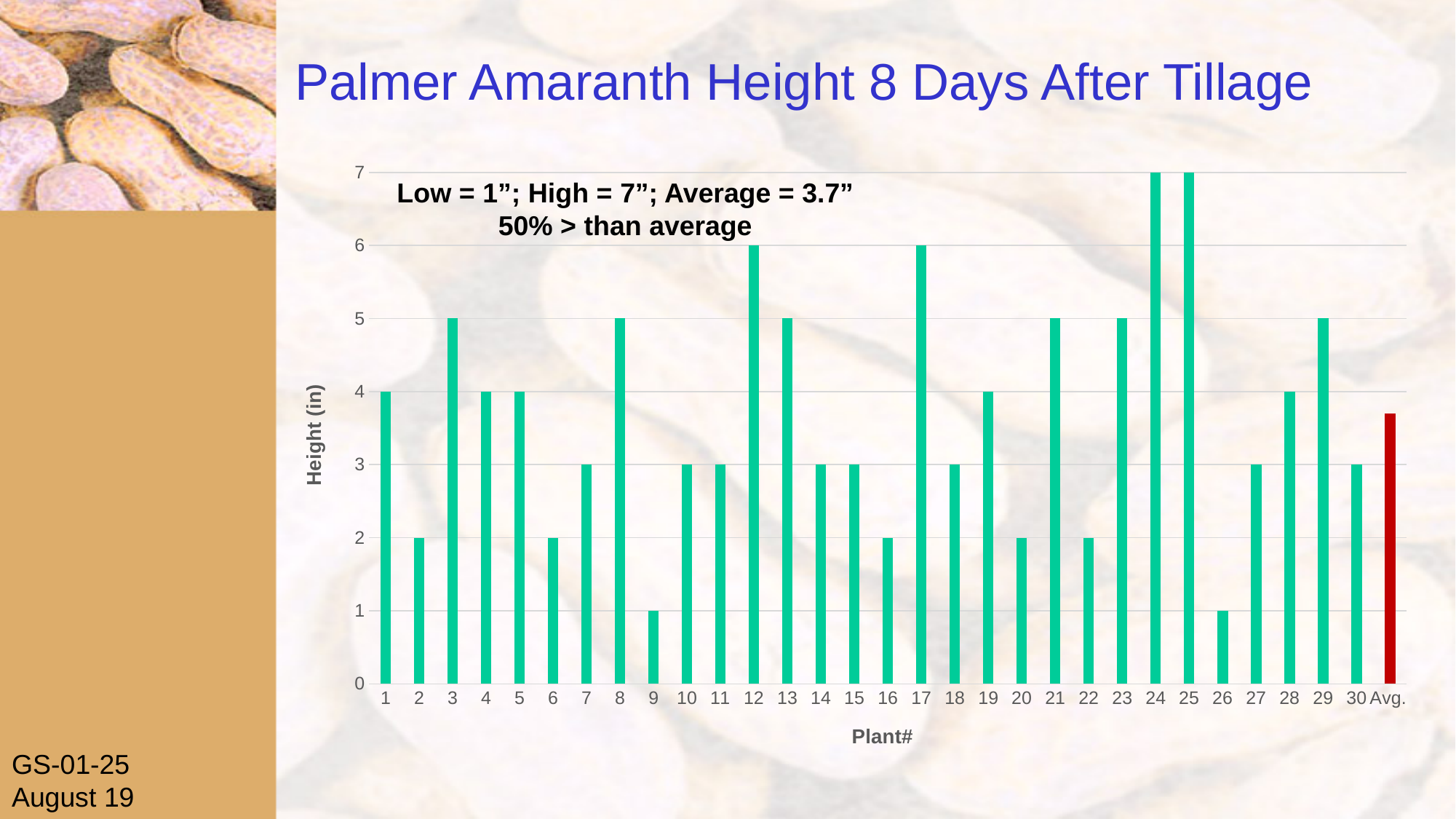
What is the height of plant 12? 6 Which plants have the highest height? 24 and 25 What is the title of the chart? Palmer Amaranth Height 8 Days After Tillage Which plants have the lowest height? 9 and 26 Is the value for plant 29 greater or less than 4? greater What is the height of plant 9? 1 What is the average height shown for the Avg. bar? 3.7" What type of chart is shown on the slide? bar chart What is the difference in height between plant 17 and plant 16? 4 How many bars are plotted on the chart, including the Avg. bar? 31 What is the height of plant 24? 7 Which is taller, plant 3 or plant 6? plant 3